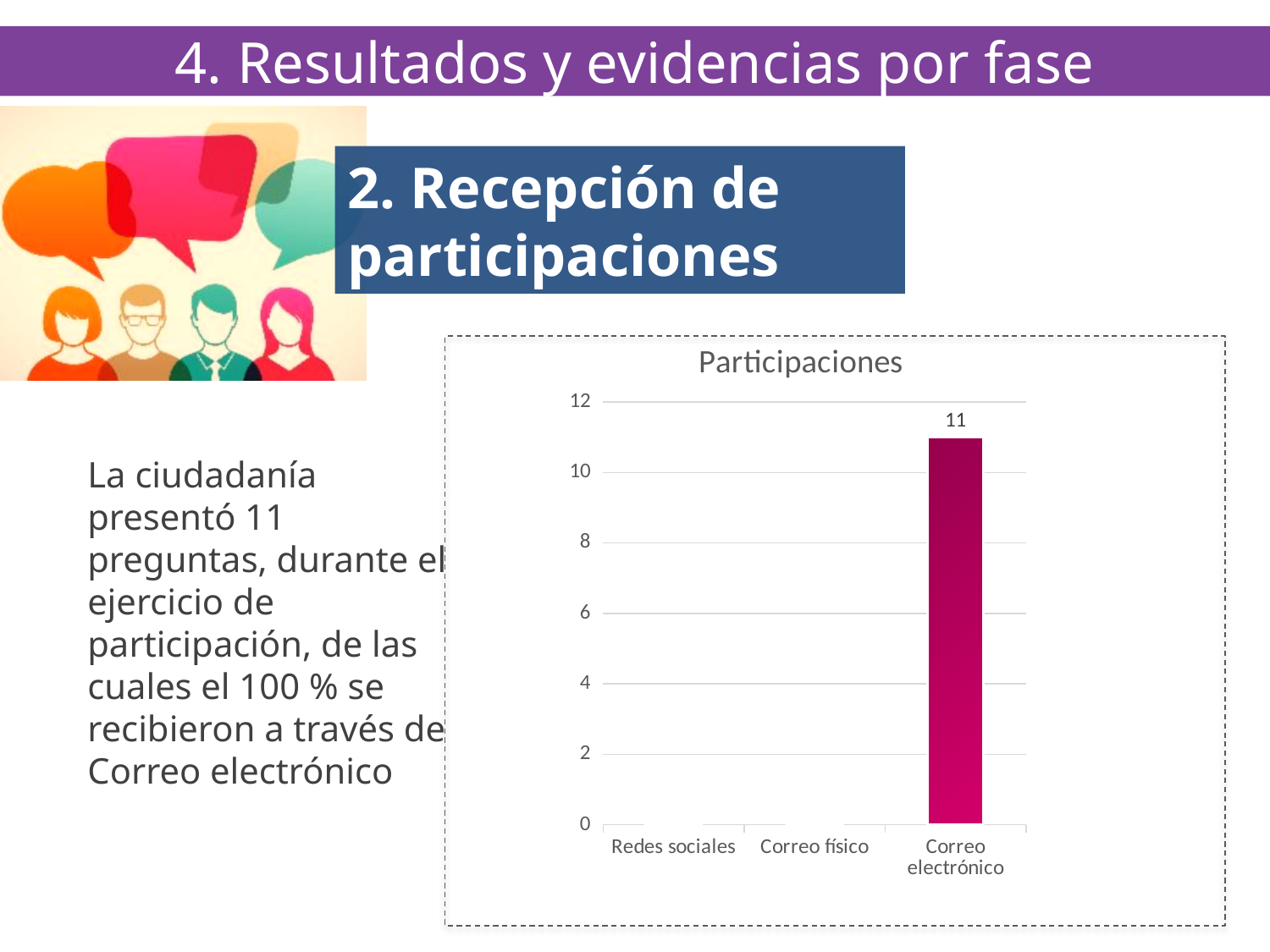
Which is larger in the Participaciones chart, the value for Correo físico or the value for Correo electrónico? Correo electrónico Is the value for Redes sociales in the Participaciones chart greater or less than 2? less Is the value for Correo físico in the Participaciones chart greater or less than 2? less Which category has the highest value in the Participaciones chart? Correo electrónico What is the title of the chart on the slide? Participaciones What is the highest value shown on the y axis of the Participaciones chart? 12 What is the value for Correo electrónico in the Participaciones chart? 11 Is the value for Correo electrónico in the Participaciones chart greater or less than 12? less Which is larger in the Participaciones chart, the value for Correo electrónico or the value for Redes sociales? Correo electrónico What kind of chart is the Participaciones chart? bar chart How many categories are shown on the x axis of the Participaciones chart? 3